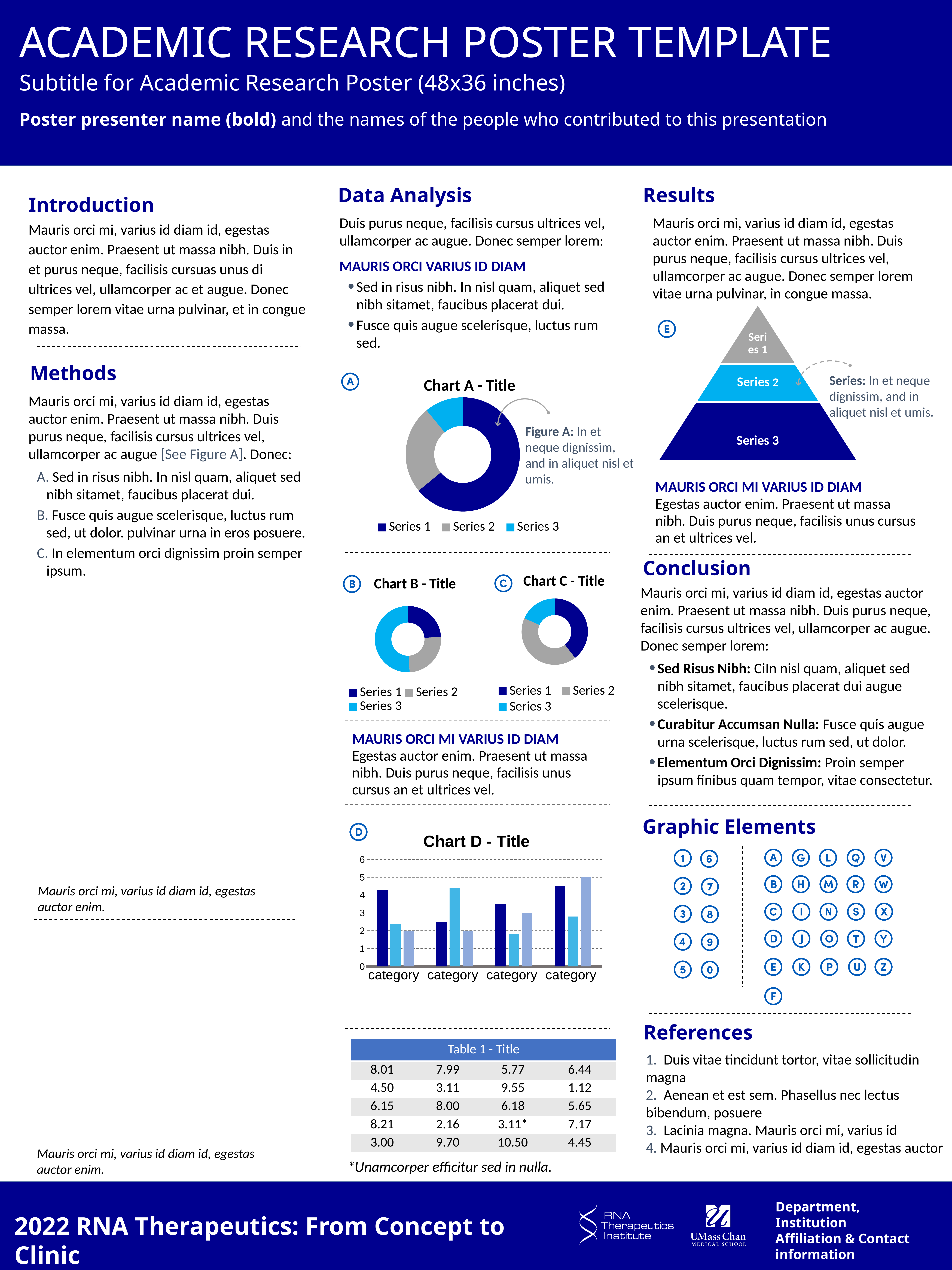
In Chart A - Title, which series has the smallest slice? Series 3 In Chart D - Title, is the tallest bar in the rightmost category group greater or less than 4? greater What kind of chart is Chart A - Title? donut chart What kind of chart is Chart D - Title? bar chart What colour is Series 2 in the legend of Chart A - Title? gray In Chart C - Title, which series has the smallest slice? Series 3 How many series does the legend of Chart A - Title list? 3 In Chart A - Title, which series has the largest slice? Series 1 In Chart D - Title, is the dark blue bar in the second category group from the left greater or less than 3? less In Chart B - Title, which series has the largest slice? Series 3 In Chart C - Title, which slice is larger, Series 1 or Series 3? Series 1 How many category groups are shown on the x axis of Chart D - Title? 4